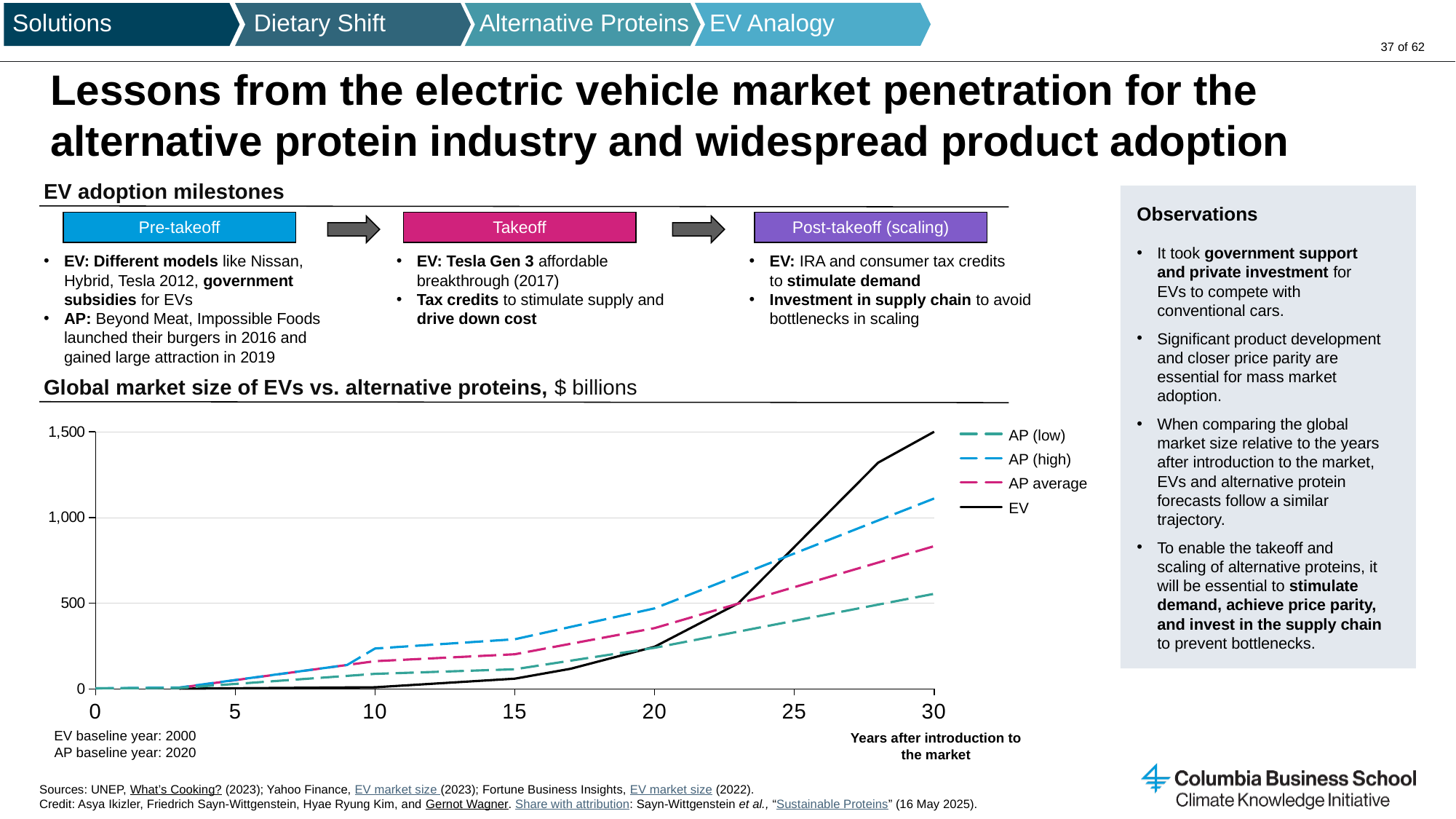
Does the EV series rise or fall as the years after introduction increase? Rise Is the EV value at 20 years after introduction greater or less than 500? less Is the AP (low) value at 30 years after introduction greater or less than 1,000? less What is the title of the chart on the slide? Global market size of EVs vs. alternative proteins, $ billions Which series has the lowest value at 30 years after introduction? AP (low) What is the x-axis label of the market size chart? Years after introduction to the market Which series has the highest value at 30 years after introduction? EV Is the EV value at 30 years after introduction greater or less than 1,000? greater At 15 years after introduction, which is larger: AP (high) or EV? AP (high) What kind of chart is used to show the global market size of EVs vs. alternative proteins? Line chart How many series does the legend of the market size chart list? 4